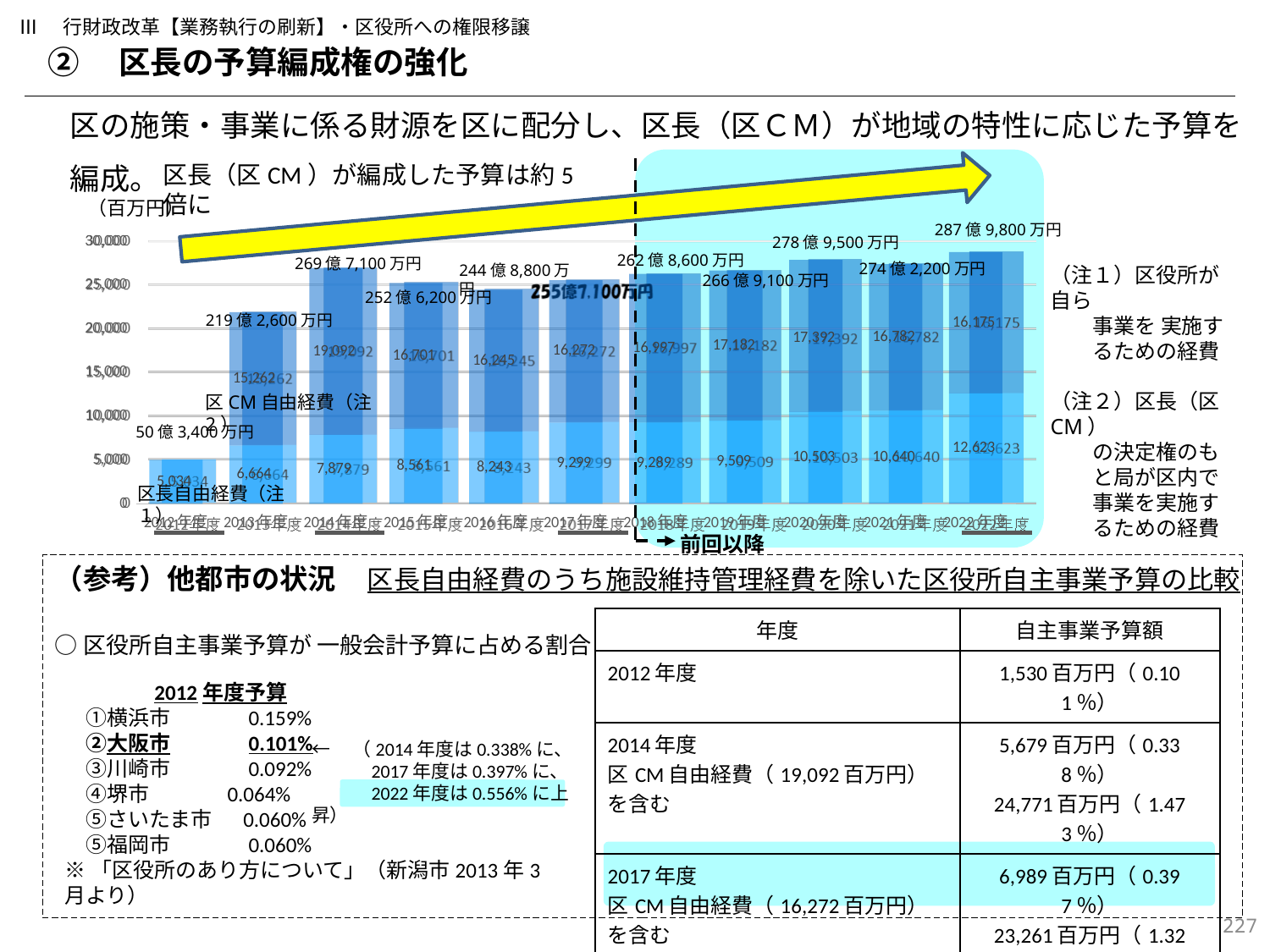
Which is larger, the 区CM自由経費（注2） value for 2014年度 or for 2022年度? 2014年度 How many series are stacked in each bar of the chart? 2 What is the 区CM自由経費（注2） value for 2014年度? 19,092 What is the 区長自由経費（注1） value for 2022年度? 12,623 Which fiscal year has the highest total labelled above its bar? 2022年度 (287億9,800万円) How many fiscal years (bars) are plotted in the chart? 11 What is the 区CM自由経費（注2） value for 2017年度? 16,272 Which fiscal year has the lowest total labelled above its bar? 2012年度 (50億3,400万円) What is the difference between the 区長自由経費（注1） values for 2022年度 and 2012年度? 7,589 What kind of chart is shown on the slide? Stacked bar chart What is the 区長自由経費（注1） value for 2012年度? 5,034 What unit is shown at the top of the chart's vertical axis? 百万円